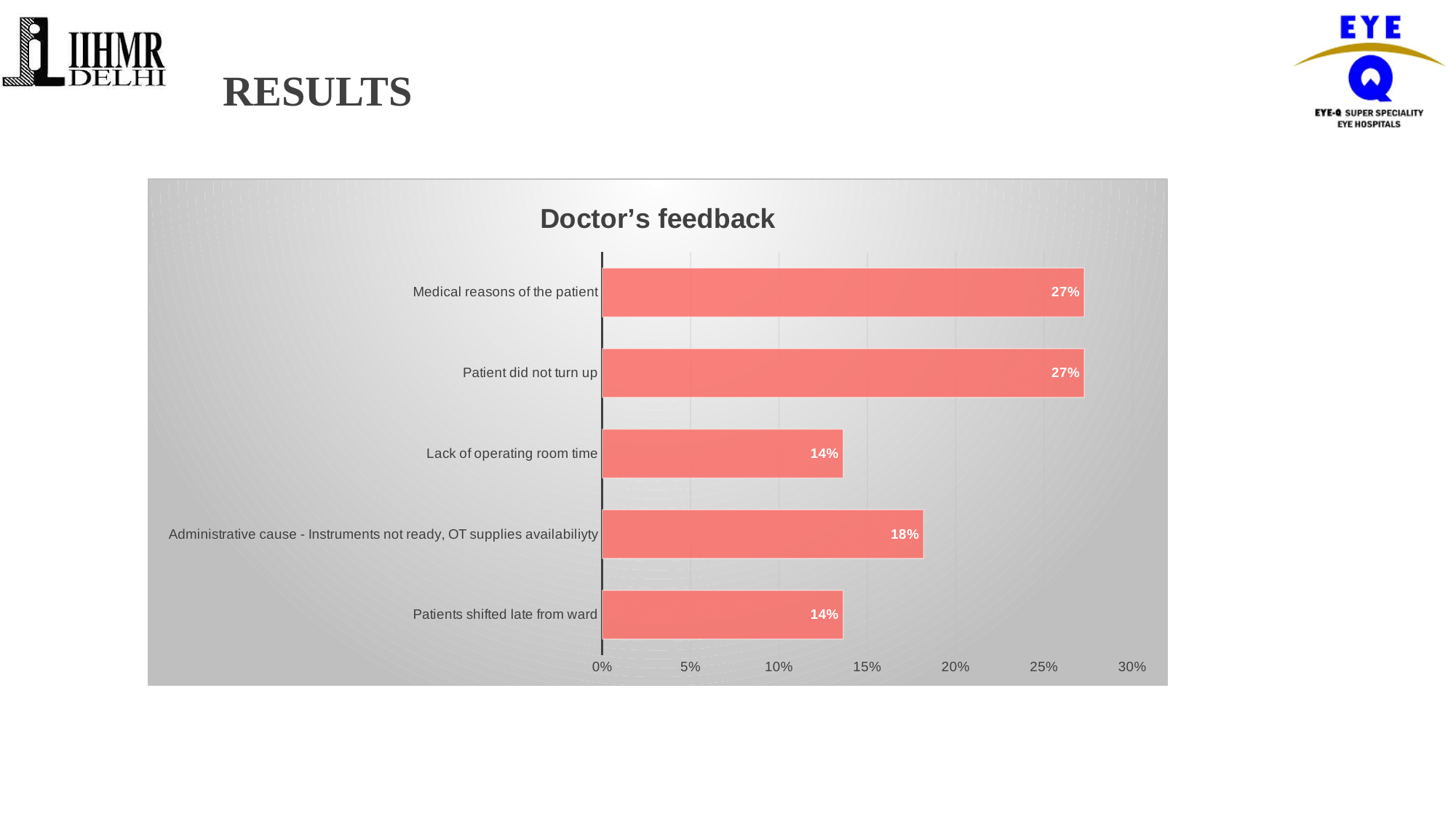
What is the value for 'Administrative cause - Instruments not ready, OT supplies availabiliyty'? 18% What is the title of the chart? Doctor's feedback What kind of chart is shown on the slide? bar chart Which is larger, the value for 'Administrative cause - Instruments not ready, OT supplies availabiliyty' or the value for 'Lack of operating room time'? Administrative cause - Instruments not ready, OT supplies availabiliyty What is the value for 'Patient did not turn up'? 27% Is the value for 'Medical reasons of the patient' greater or less than 25%? greater What is the value for 'Lack of operating room time'? 14% What is the difference between the values for 'Medical reasons of the patient' and 'Administrative cause - Instruments not ready, OT supplies availabiliyty'? 9% How many categories are shown in the chart? 5 What is the value for 'Patients shifted late from ward'? 14% What is the difference between the values for 'Administrative cause - Instruments not ready, OT supplies availabiliyty' and 'Patients shifted late from ward'? 4% Is the value for 'Patients shifted late from ward' greater or less than 15%? less